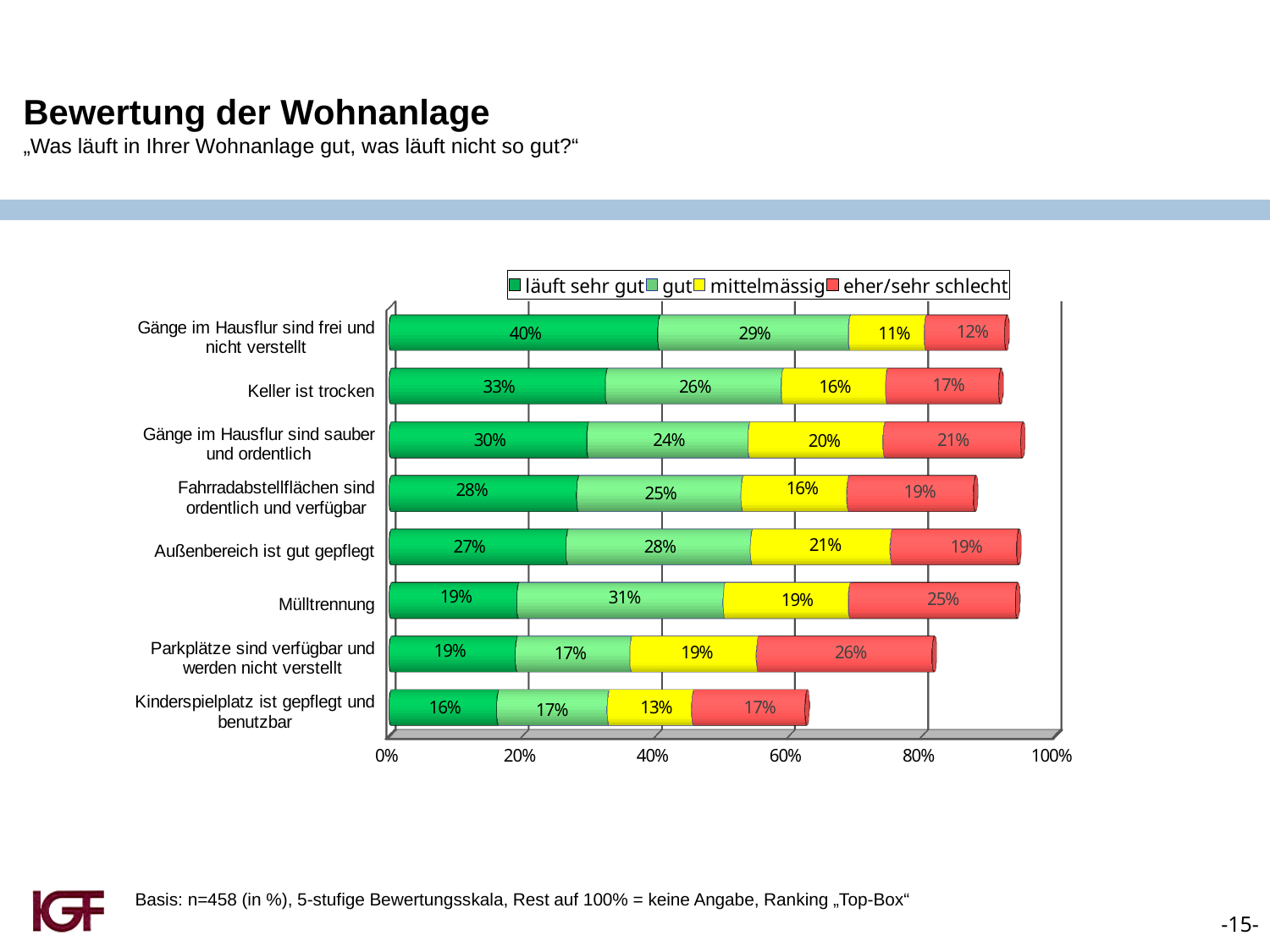
How many series does the legend list? 4 What is the difference between the "läuft sehr gut" values for "Gänge im Hausflur sind frei und nicht verstellt" and "Keller ist trocken"? 7 percentage points How many categories are shown on the chart? 8 What is the "eher/sehr schlecht" value for "Mülltrennung"? 25% What is the total of the stacked bar for "Kinderspielplatz ist gepflegt und benutzbar"? 63% Which category has the highest "läuft sehr gut" value? Gänge im Hausflur sind frei und nicht verstellt What is the "mittelmässig" value for "Außenbereich ist gut gepflegt"? 21% What percentage of respondents rated "Keller ist trocken" as "läuft sehr gut"? 33% Which colour represents "eher/sehr schlecht" in the legend? Red Which category has the lowest "läuft sehr gut" value? Kinderspielplatz ist gepflegt und benutzbar What kind of chart is shown on the slide? Stacked bar chart Which is larger: the "gut" value for "Mülltrennung" or the "gut" value for "Parkplätze sind verfügbar und werden nicht verstellt"? Mülltrennung